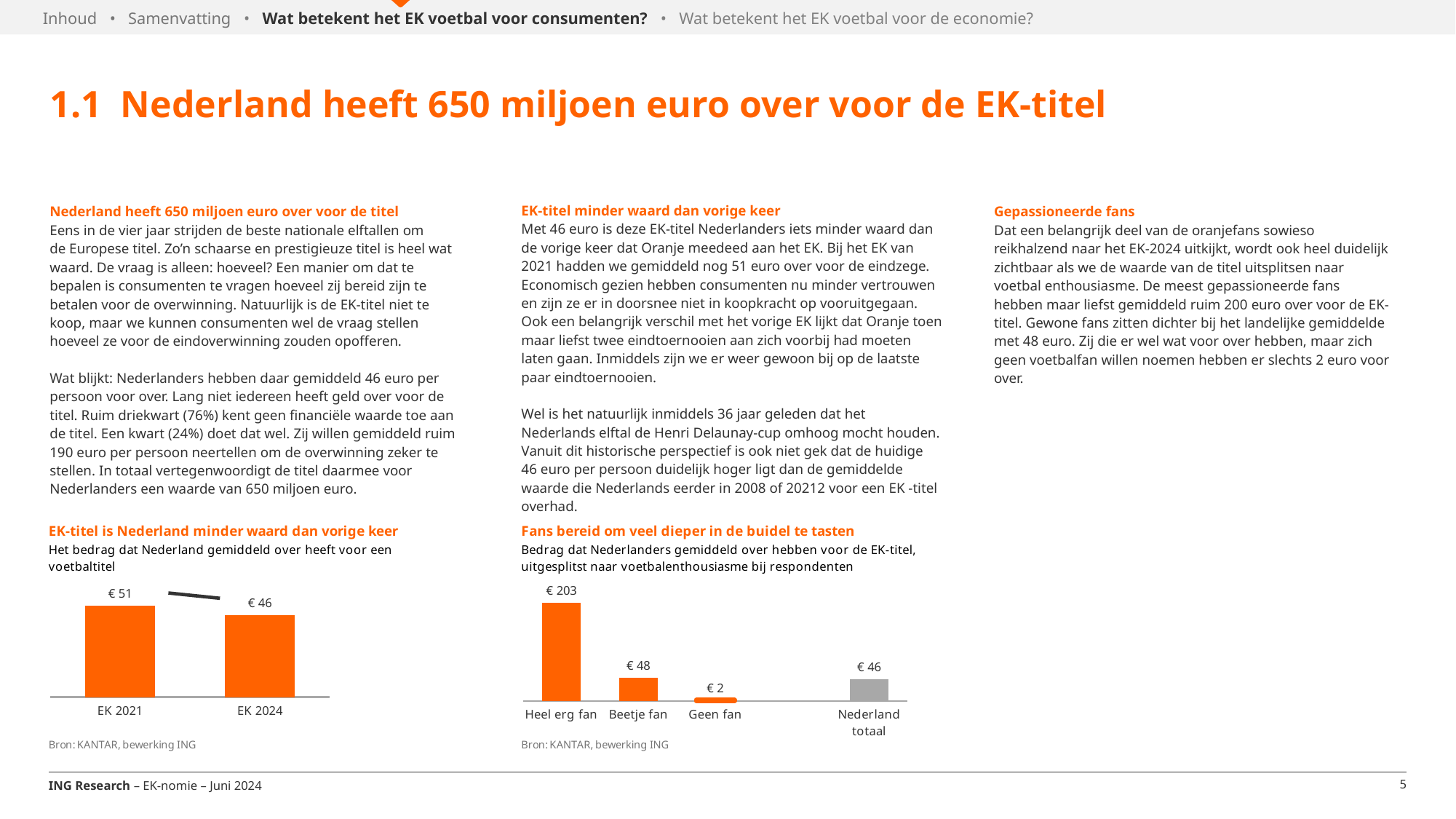
In the right chart 'Fans bereid om veel dieper in de buidel te tasten', which category has the highest value? Heel erg fan In the right chart 'Fans bereid om veel dieper in de buidel te tasten', what is the difference between Heel erg fan and Beetje fan? € 155 In the left chart 'EK-titel is Nederland minder waard dan vorige keer', how many categories are shown? 2 In the right chart 'Fans bereid om veel dieper in de buidel te tasten', which is larger: Beetje fan or Nederland totaal? Beetje fan In the right chart 'Fans bereid om veel dieper in de buidel te tasten', what is the value for Heel erg fan? € 203 In the left chart 'EK-titel is Nederland minder waard dan vorige keer', what is the value for EK 2024? € 46 In the right chart 'Fans bereid om veel dieper in de buidel te tasten', which category has the lowest value? Geen fan In the left chart 'EK-titel is Nederland minder waard dan vorige keer', do the values rise or fall from EK 2021 to EK 2024? fall In the right chart 'Fans bereid om veel dieper in de buidel te tasten', what is the value for Geen fan? € 2 In the left chart 'EK-titel is Nederland minder waard dan vorige keer', what is the difference between the EK 2021 and EK 2024 values? € 5 What type of chart is the right chart 'Fans bereid om veel dieper in de buidel te tasten'? bar chart In the left chart 'EK-titel is Nederland minder waard dan vorige keer', what is the value for EK 2021? € 51